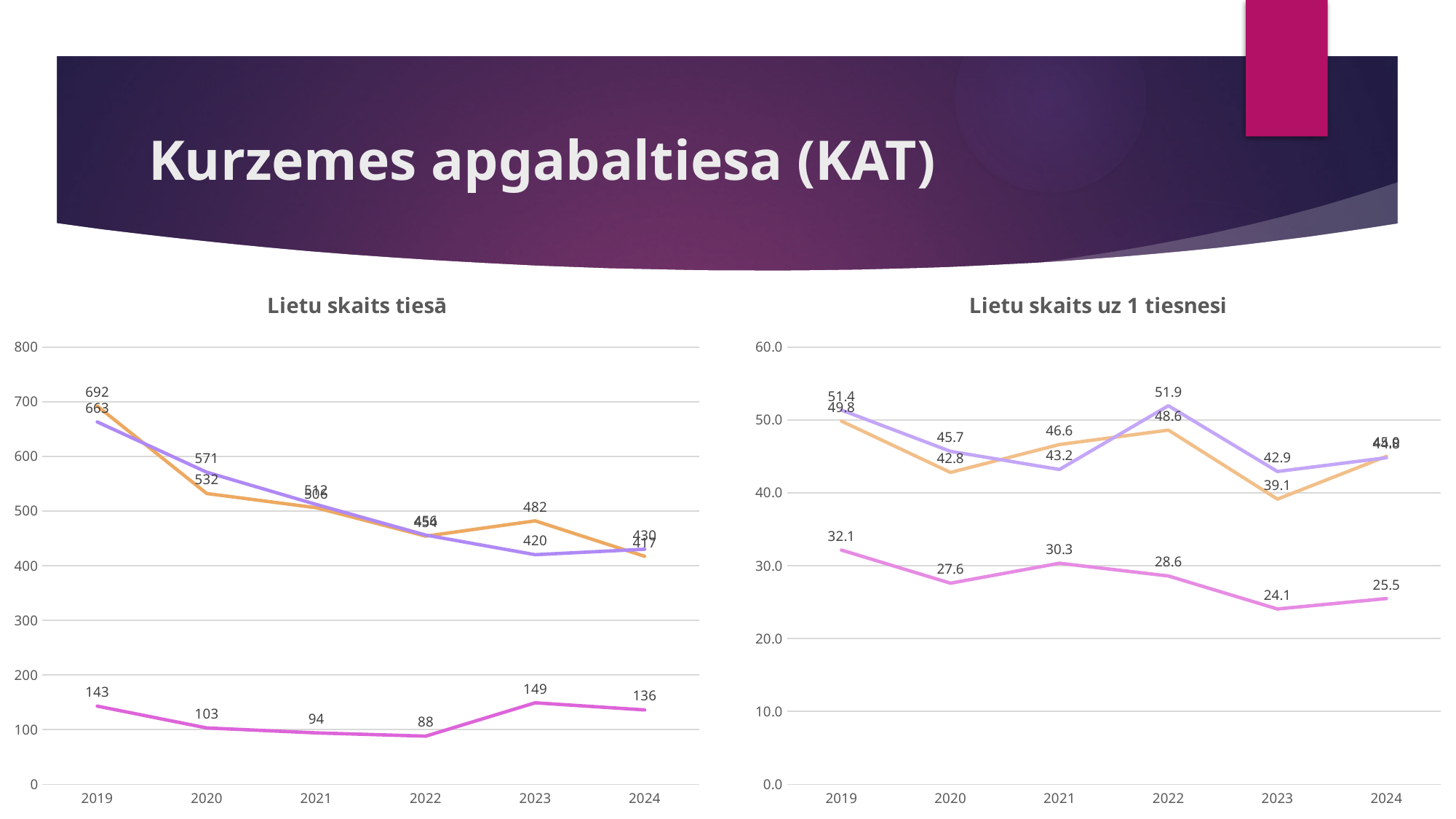
In the left chart "Lietu skaits tiesā", which line has the higher value in 2020, the orange or the purple one? purple In the left chart "Lietu skaits tiesā", what is the value of the orange line in 2019? 692 In the right chart "Lietu skaits uz 1 tiesnesi", what is the value of the pink line in 2021? 30.3 In the left chart "Lietu skaits tiesā", is the value of the purple line in 2023 greater or less than 400? greater What kind of chart is the left chart titled "Lietu skaits tiesā"? line chart In the left chart "Lietu skaits tiesā", how many years are shown on the x axis? 6 In the left chart "Lietu skaits tiesā", what is the difference between the pink line's values in 2023 and 2022? 61 In the right chart "Lietu skaits uz 1 tiesnesi", does the pink line rise or fall from 2019 to 2020? fall In the right chart "Lietu skaits uz 1 tiesnesi", in which year does the purple line reach its highest value? 2022 In the left chart "Lietu skaits tiesā", in which year is the pink line at its lowest? 2022 In the left chart "Lietu skaits tiesā", what is the value of the pink line in 2019? 143 In the right chart "Lietu skaits uz 1 tiesnesi", by how much does the orange line drop from 2022 to 2023? 9.5